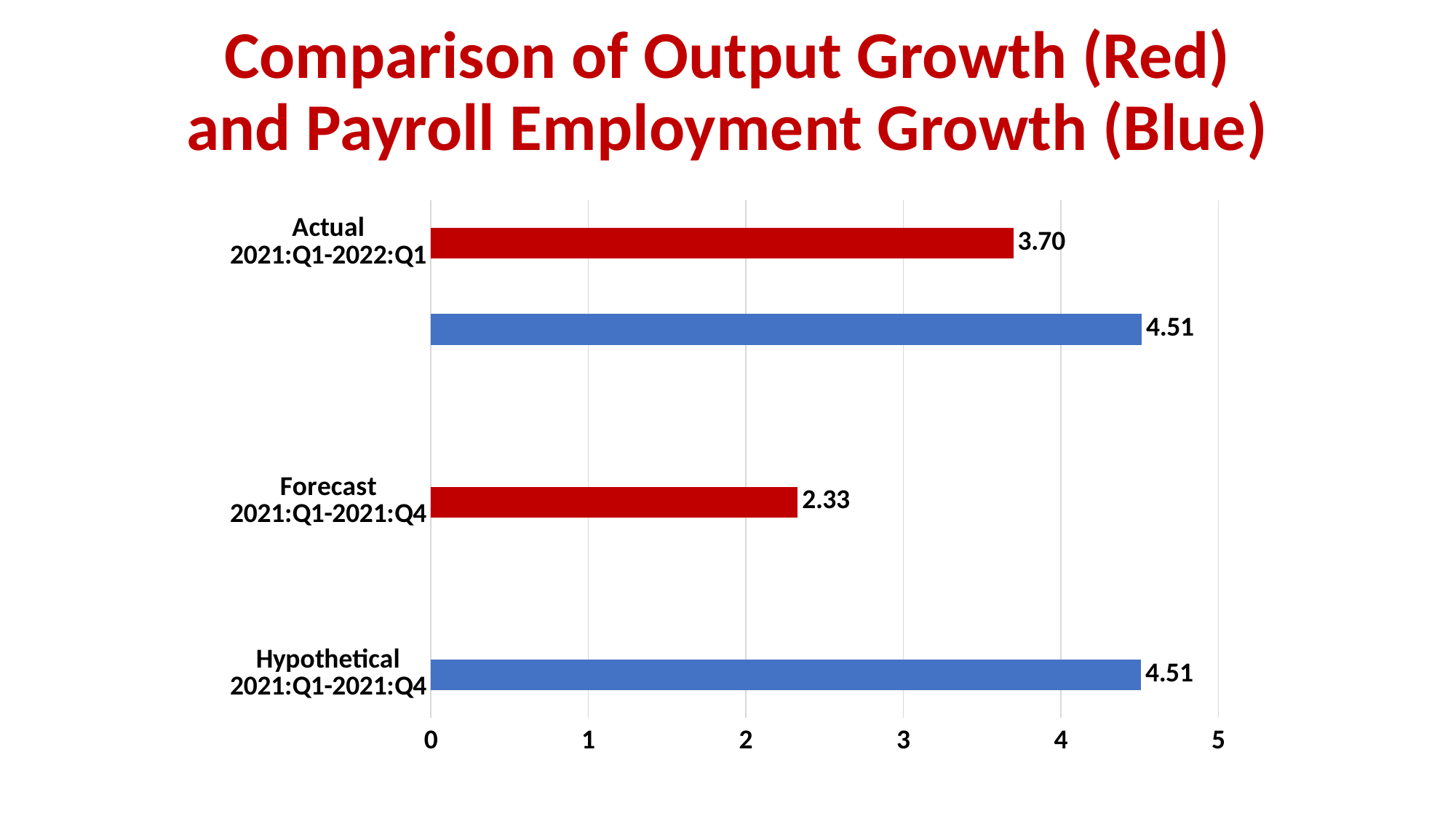
What is the output growth (red bar) value for Actual 2021:Q1-2022:Q1? 3.70 Which category has the lowest value shown on the chart? Forecast 2021:Q1-2021:Q4 Is the value for Forecast 2021:Q1-2021:Q4 greater or less than 3? less What is the difference between the red bar for Actual 2021:Q1-2022:Q1 and the red bar for Forecast 2021:Q1-2021:Q4? 1.37 Which red bar is longer: Actual 2021:Q1-2022:Q1 or Forecast 2021:Q1-2021:Q4? Actual 2021:Q1-2022:Q1 What is the difference between the blue bar (4.51) and the red bar (3.70) for Actual 2021:Q1-2022:Q1? 0.81 What kind of chart is shown on the slide? Bar chart How many category labels are shown on the vertical axis of the chart? 3 What is the output growth (red bar) value for Forecast 2021:Q1-2021:Q4? 2.33 According to the chart title, which colour represents payroll employment growth? Blue What is the payroll employment growth (blue bar) value for Actual 2021:Q1-2022:Q1? 4.51 What is the payroll employment growth (blue bar) value for Hypothetical 2021:Q1-2021:Q4? 4.51